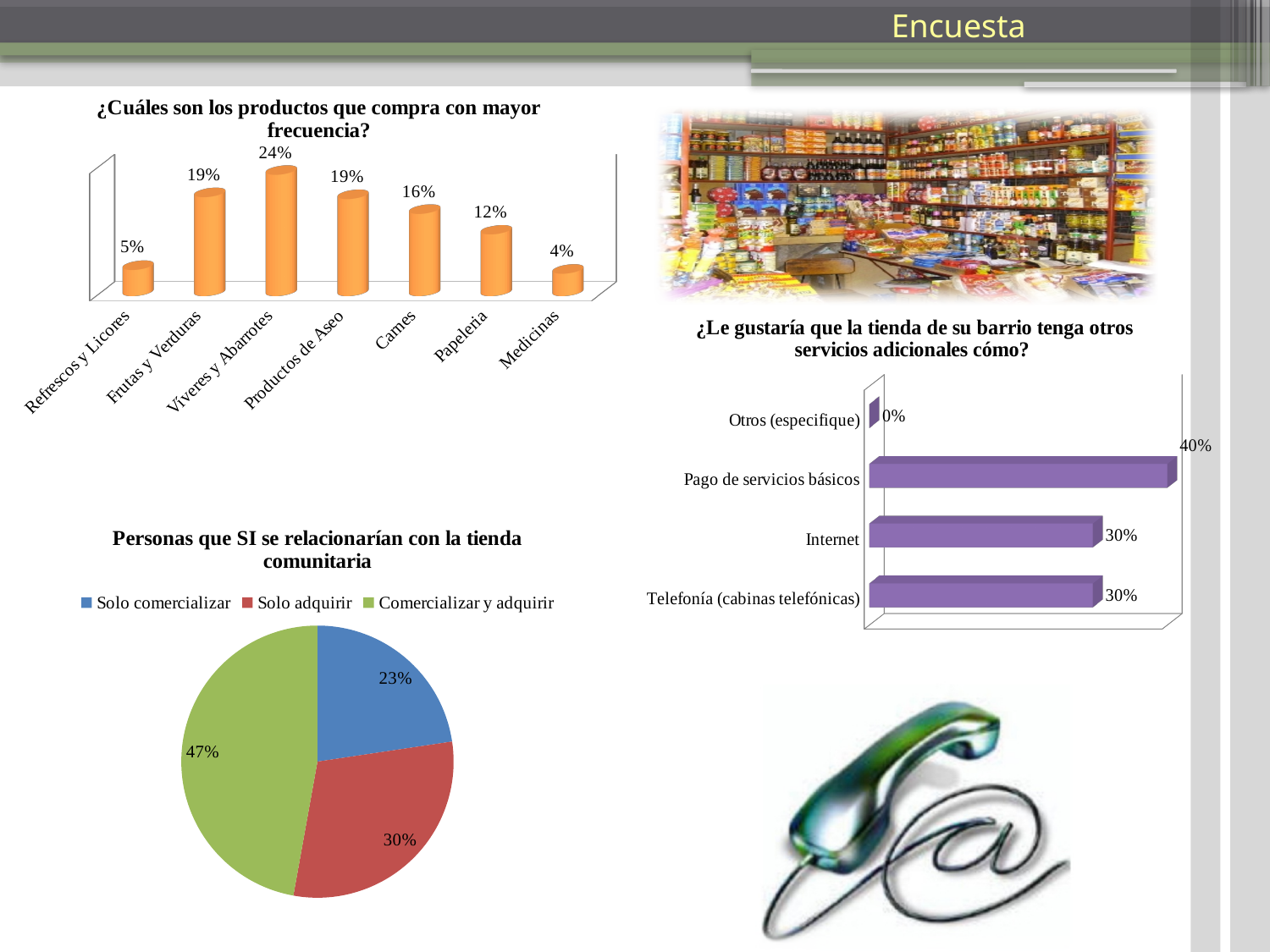
In the pie chart 'Personas que SI se relacionarían con la tienda comunitaria', how many entries does the legend list? 3 In the chart '¿Le gustaría que la tienda de su barrio tenga otros servicios adicionales cómo?', which service has the highest value? Pago de servicios básicos In the chart '¿Cuáles son los productos que compra con mayor frecuencia?', what is the value for Víveres y Abarrotes? 24% In the chart '¿Cuáles son los productos que compra con mayor frecuencia?', what is the difference between Carnes and Papelería? 4% In the chart '¿Cuáles son los productos que compra con mayor frecuencia?', which product has the lowest value? Medicinas In the pie chart 'Personas que SI se relacionarían con la tienda comunitaria', what share is Comercializar y adquirir? 47% What kind of chart is '¿Cuáles son los productos que compra con mayor frecuencia?'? Bar chart In the chart '¿Cuáles son los productos que compra con mayor frecuencia?', which product has the highest value? Víveres y Abarrotes In the chart '¿Le gustaría que la tienda de su barrio tenga otros servicios adicionales cómo?', what is the value for Otros (especifique)? 0% In the chart '¿Cuáles son los productos que compra con mayor frecuencia?', how many product categories are shown? 7 In the chart '¿Le gustaría que la tienda de su barrio tenga otros servicios adicionales cómo?', how many categories are shown? 4 In the chart '¿Le gustaría que la tienda de su barrio tenga otros servicios adicionales cómo?', what is the value for Pago de servicios básicos? 40%